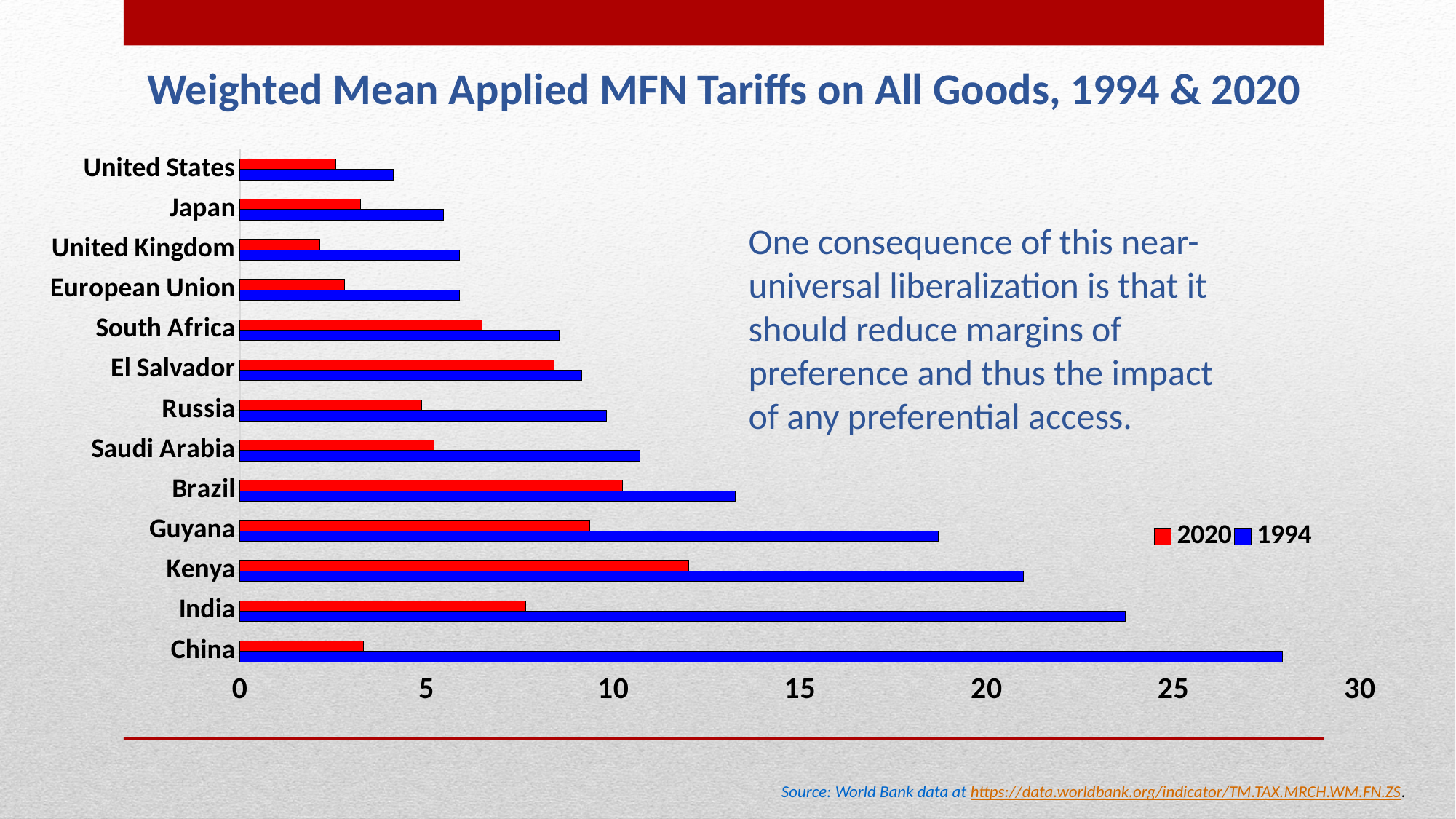
What kind of chart is shown on the slide? bar chart Is the 2020 value for Kenya greater or less than 10? greater Which country has the lowest 1994 tariff value? United States How many countries or regions are listed on the chart? 13 Which country has the highest 1994 tariff value? China Is the 1994 value for China greater or less than 25? greater Which is larger, the 2020 value for India or the 2020 value for China? India How many series does the legend list? 2 Is the 1994 value for the United States greater or less than 5? less Which country has the highest 2020 tariff value? Kenya Which colour represents the 2020 series in the legend? red